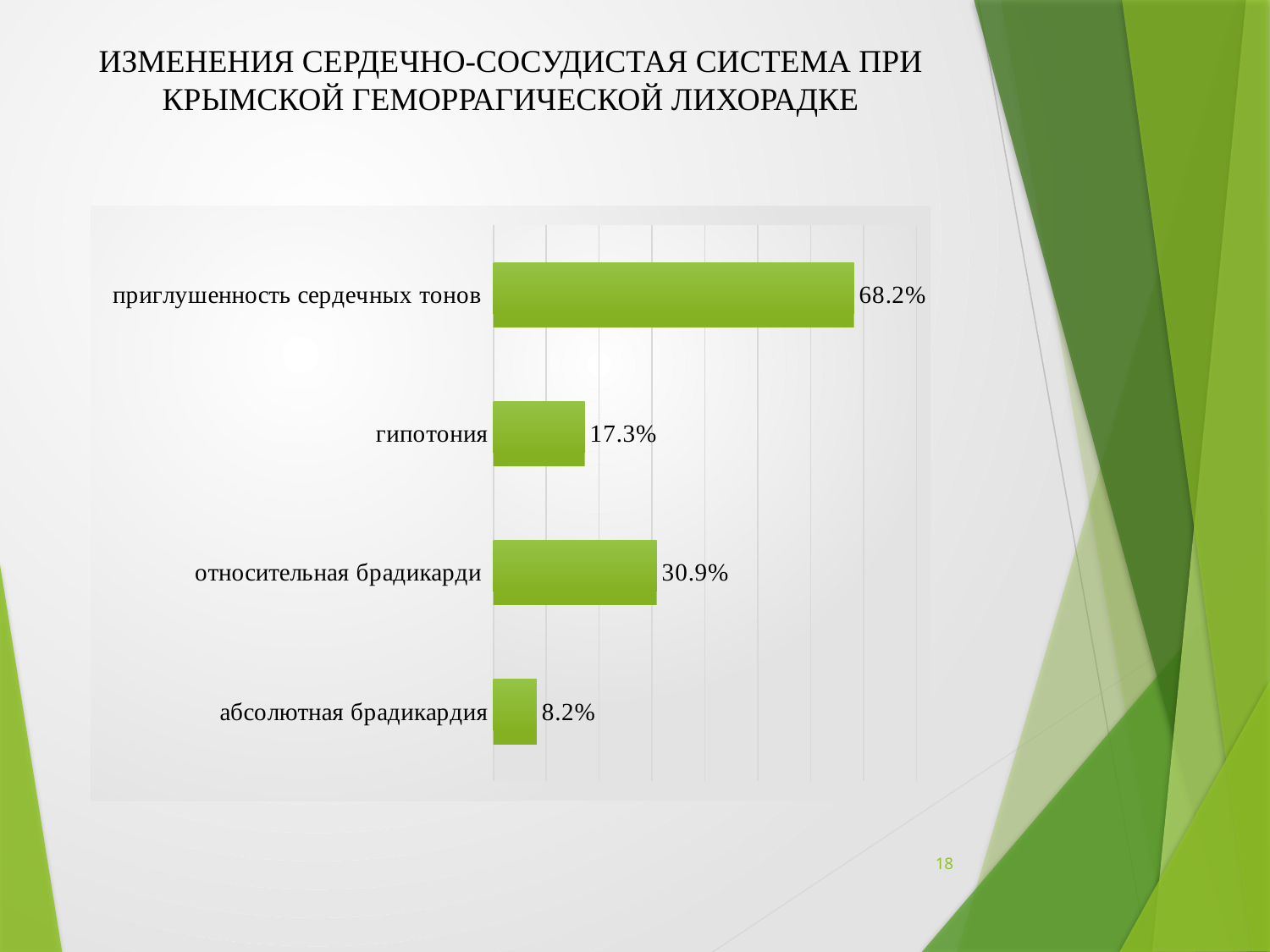
What is the difference between the values for относительная брадикарди and абсолютная брадикардия? 22.7% What is the difference between the values for приглушенность сердечных тонов and гипотония? 50.9% Which category has the lowest value? абсолютная брадикардия What is the value for абсолютная брадикардия? 8.2% How many categories are shown in the chart? 4 Which category has the highest value? приглушенность сердечных тонов What colour are the bars in the chart? green What is the value for приглушенность сердечных тонов? 68.2% What is the value for гипотония? 17.3% Which is larger, the value for гипотония or the value for относительная брадикарди? относительная брадикарди What kind of chart is shown on the slide? bar chart What is the value for относительная брадикарди? 30.9%